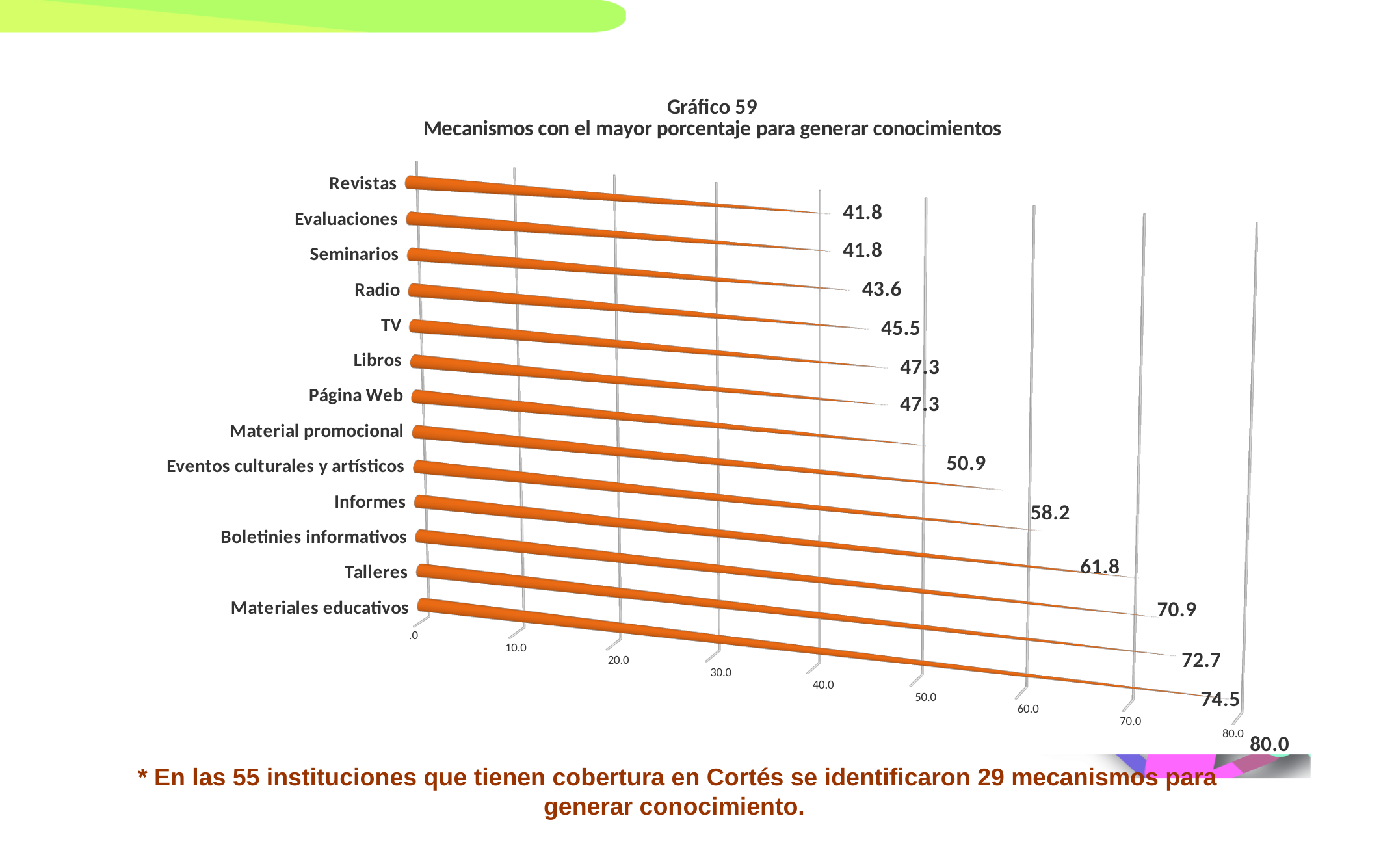
What is the title of the chart? Gráfico 59 Mecanismos con el mayor porcentaje para generar conocimientos Is the value for Seminarios greater or less than 50.0? less What is the difference between the values for Materiales educativos and Talleres? 5.5 What is the value for Materiales educativos? 80.0 What is the value for Radio? 45.5 What is the difference between the values for Eventos culturales y artísticos and Página Web? 10.9 Which category has the highest value? Materiales educativos What is the value for Informes? 70.9 Which is larger, the value for Boletinies informativos or the value for Informes? Boletinies informativos What is the value for Material promocional? 58.2 What kind of chart is shown on the slide? bar chart How many categories are plotted in the chart? 13